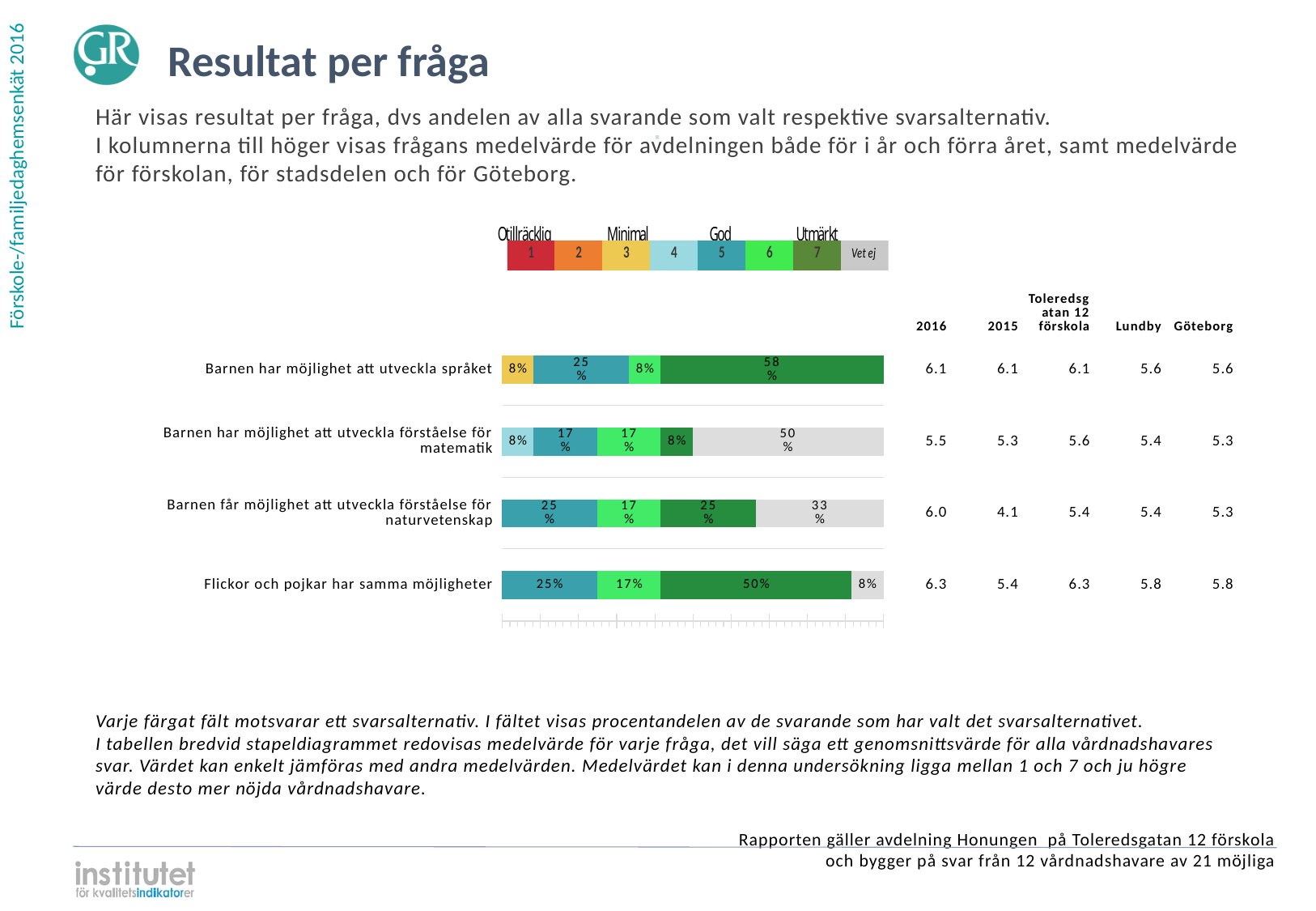
For 'Barnen har möjlighet att utveckla förståelse för matematik', is the 2016 mean or the 2015 mean larger? 2016 What is the title of the slide containing the chart? Resultat per fråga Which question has the lowest 2015 mean value? Barnen får möjlighet att utveckla förståelse för naturvetenskap What percentage is shown in the grey (Vet ej) segment for 'Barnen har möjlighet att utveckla förståelse för matematik'? 50% How many questions (categories) are plotted in the bar chart? 4 How many response options does the colour legend above the chart list? 8 What is the difference between the 2016 and 2015 mean values for 'Barnen får möjlighet att utveckla förståelse för naturvetenskap'? 1.9 What kind of chart is shown on the slide? Stacked bar chart What is the 2016 mean value for 'Flickor och pojkar har samma möjligheter'? 6.3 What is the total of all segments in the bar for 'Flickor och pojkar har samma möjligheter'? 100% What is the largest segment value in the bar for 'Barnen har möjlighet att utveckla språket'? 58% What is the value of the first (leftmost) segment in the bar for 'Flickor och pojkar har samma möjligheter'? 25%